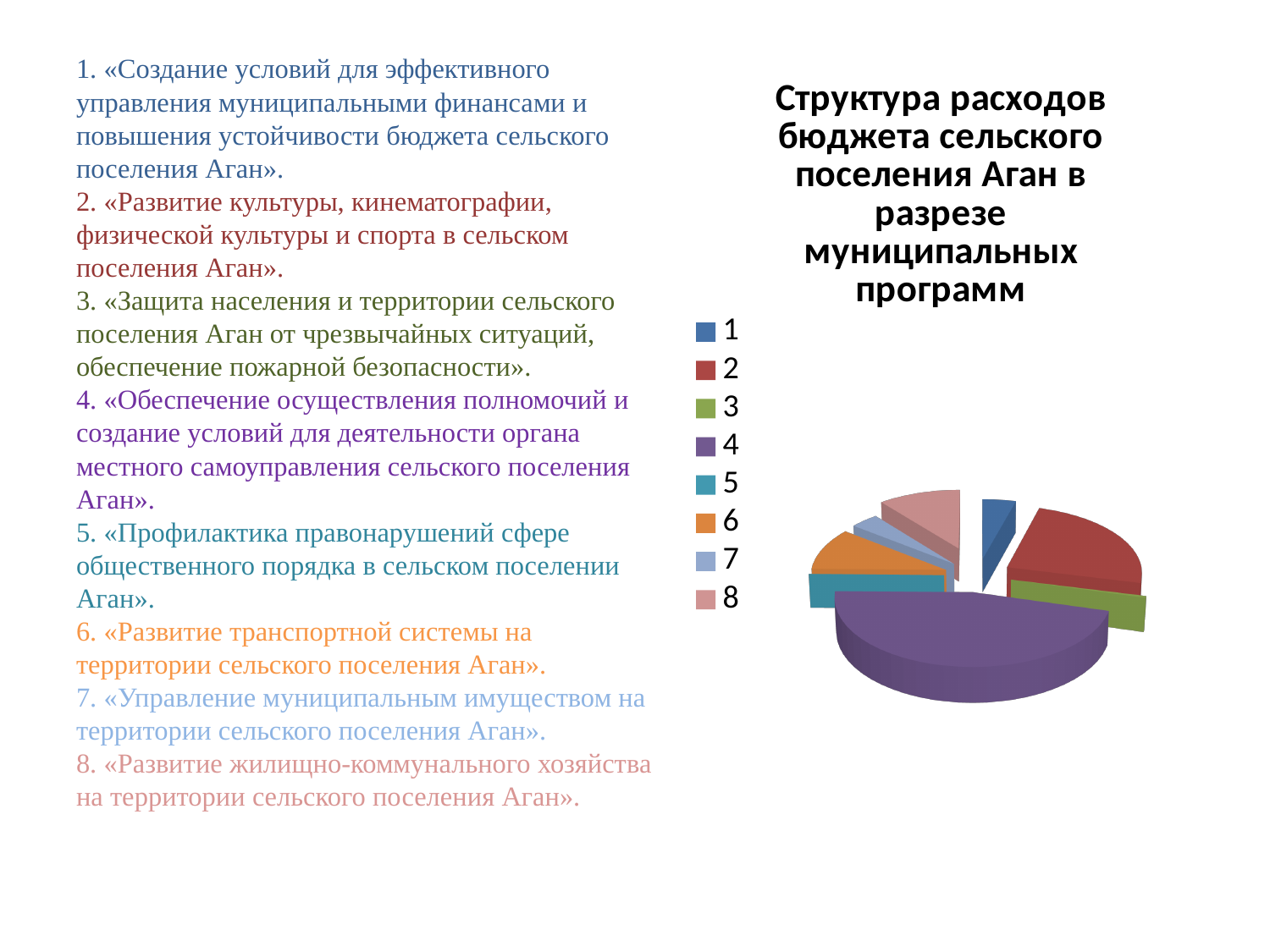
What is the title of the pie chart? Структура расходов бюджета сельского поселения Аган в разрезе муниципальных программ Which slice is larger in the pie chart, category 6 or category 3? 6 Which slice is larger in the pie chart, category 8 or category 7? 8 What kind of chart is shown on the slide? pie chart What colour is the slice for category 4 in the pie chart? purple Which slice is larger in the pie chart, category 4 or category 1? 4 Which category has the largest slice in the pie chart? 4 How many slices does the pie chart have? 8 How many entries does the legend of the pie chart list? 8